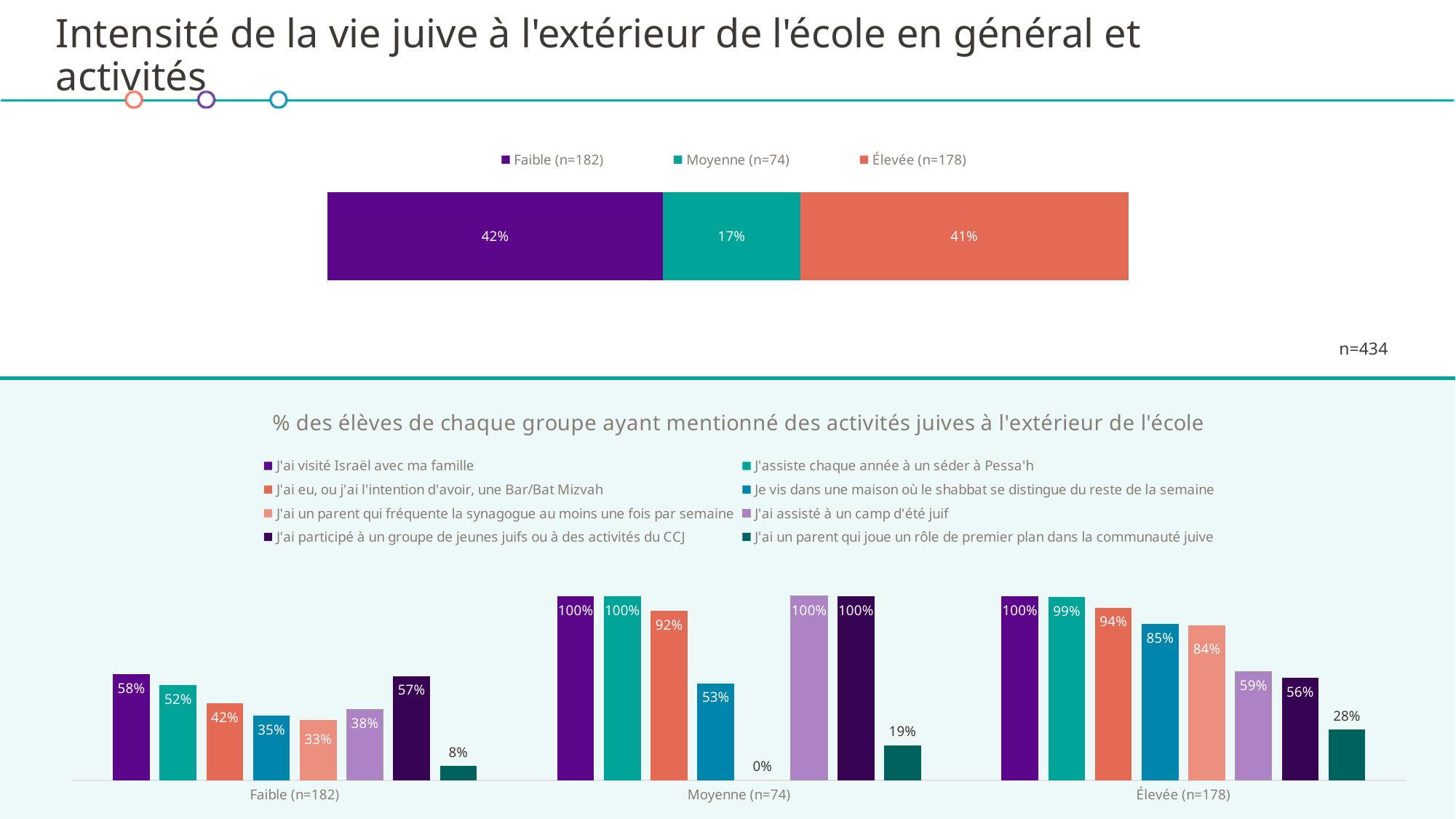
In the top stacked bar chart, what percentage is shown for Faible (n=182)? 42% In the bottom chart, which is larger in the Faible (n=182) group: 'J'ai assisté à un camp d'été juif' or 'J'ai participé à un groupe de jeunes juifs ou à des activités du CCJ'? J'ai participé à un groupe de jeunes juifs ou à des activités du CCJ What type of chart is the bottom chart? Bar chart In the top stacked bar chart, which segment is the smallest? Moyenne (n=74) In the top stacked bar chart, how many series does the legend list? 3 In the top stacked bar chart, what percentage is shown for Moyenne (n=74)? 17% In the bottom chart, what is the difference between 'J'ai visité Israël avec ma famille' in the Élevée (n=178) group and in the Faible (n=182) group? 42% In the bottom chart, what is the value for 'Je vis dans une maison où le shabbat se distingue du reste de la semaine' in the Élevée (n=178) group? 85% In the bottom chart, what is the value for 'J'ai un parent qui joue un rôle de premier plan dans la communauté juive' in the Faible (n=182) group? 8% In the bottom chart, what is the value for 'J'ai un parent qui fréquente la synagogue au moins une fois par semaine' in the Moyenne (n=74) group? 0% In the bottom chart, how many series does the legend list? 8 In the bottom chart, how many groups are shown on the x axis? 3